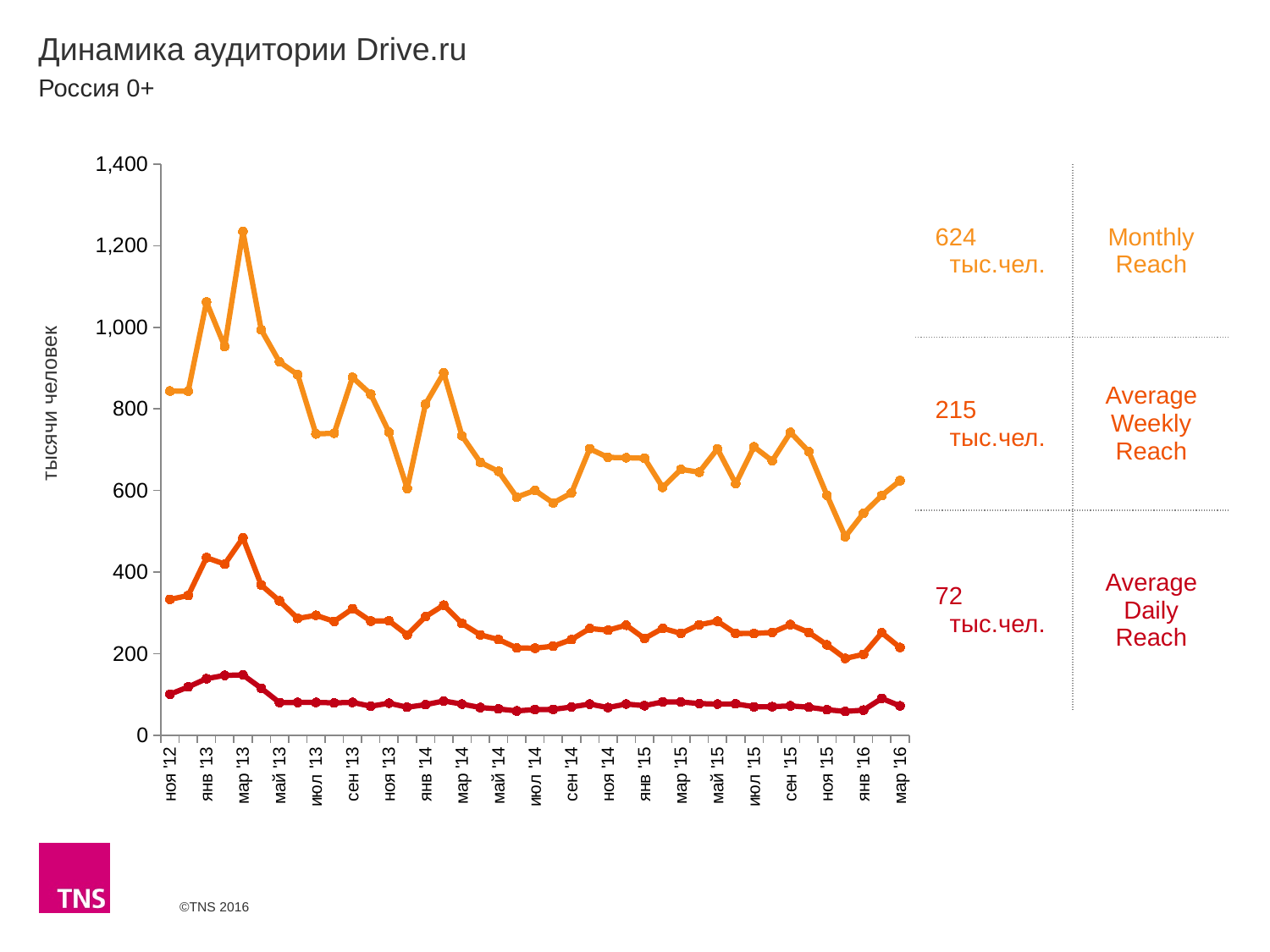
In which month does the Monthly Reach line reach its peak? мар '13 What kind of chart is shown on the slide? line chart What is the Monthly Reach value for мар '16 shown on the slide? 624 тыс.чел. Which series has the highest values throughout the chart? Monthly Reach Is the Monthly Reach value for мар '13 greater or less than 1,000? greater What is the Average Weekly Reach value for мар '16 shown on the slide? 215 тыс.чел. What is the difference between the Monthly Reach and the Average Weekly Reach values shown for мар '16? 409 тыс.чел. What is the Average Daily Reach value for мар '16 shown on the slide? 72 тыс.чел. Does the Monthly Reach line overall rise or fall from мар '13 to мар '16? fall What is the label on the vertical axis of the chart? тысячи человек What is the difference between the Average Weekly Reach and the Average Daily Reach values shown for мар '16? 143 тыс.чел. How many series are plotted on the chart? 3